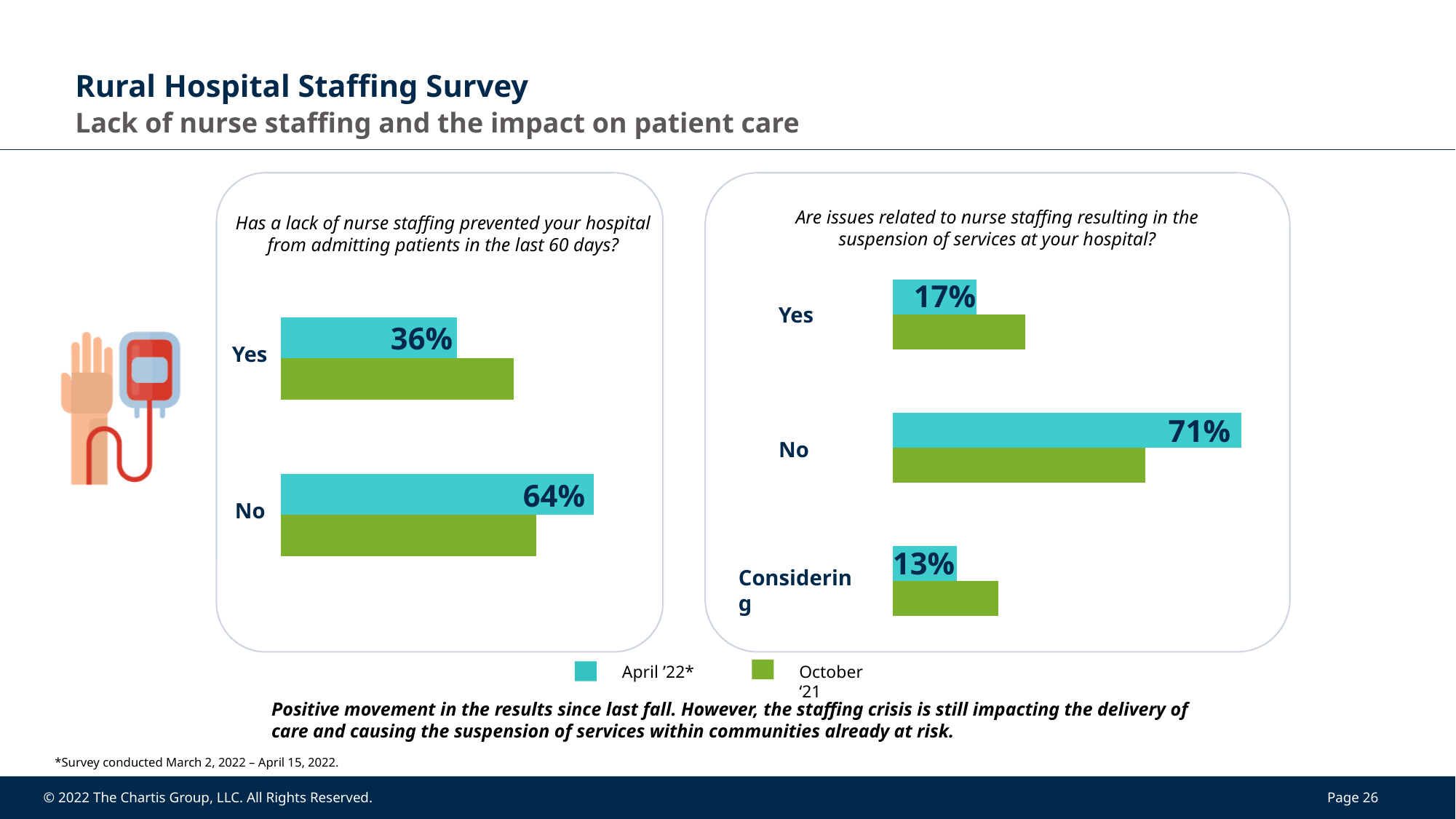
In the left chart (admitting patients in the last 60 days), what percentage answered No in April '22? 64% In the right chart (suspension of services), what is the difference in percentage points between the April '22 No and Yes responses? 54 percentage points In the right chart (suspension of services), which response had the highest April '22 percentage? No In the right chart (suspension of services), what percentage answered Considering in April '22? 13% In the right chart (suspension of services), what percentage answered No in April '22? 71% In the left chart (admitting patients in the last 60 days), for the Yes response, which bar is longer: April '22 or October '21? October '21 In the left chart (admitting patients in the last 60 days), what is the difference in percentage points between the April '22 No and Yes responses? 28 percentage points In the right chart (suspension of services), which response had the lowest April '22 percentage? Considering How many series does the legend list for the charts? 2 In the right chart (suspension of services), what percentage answered Yes in April '22? 17% In the left chart (admitting patients in the last 60 days), what percentage answered Yes in April '22? 36% What type of chart is used in the right panel (suspension of services)? Bar chart